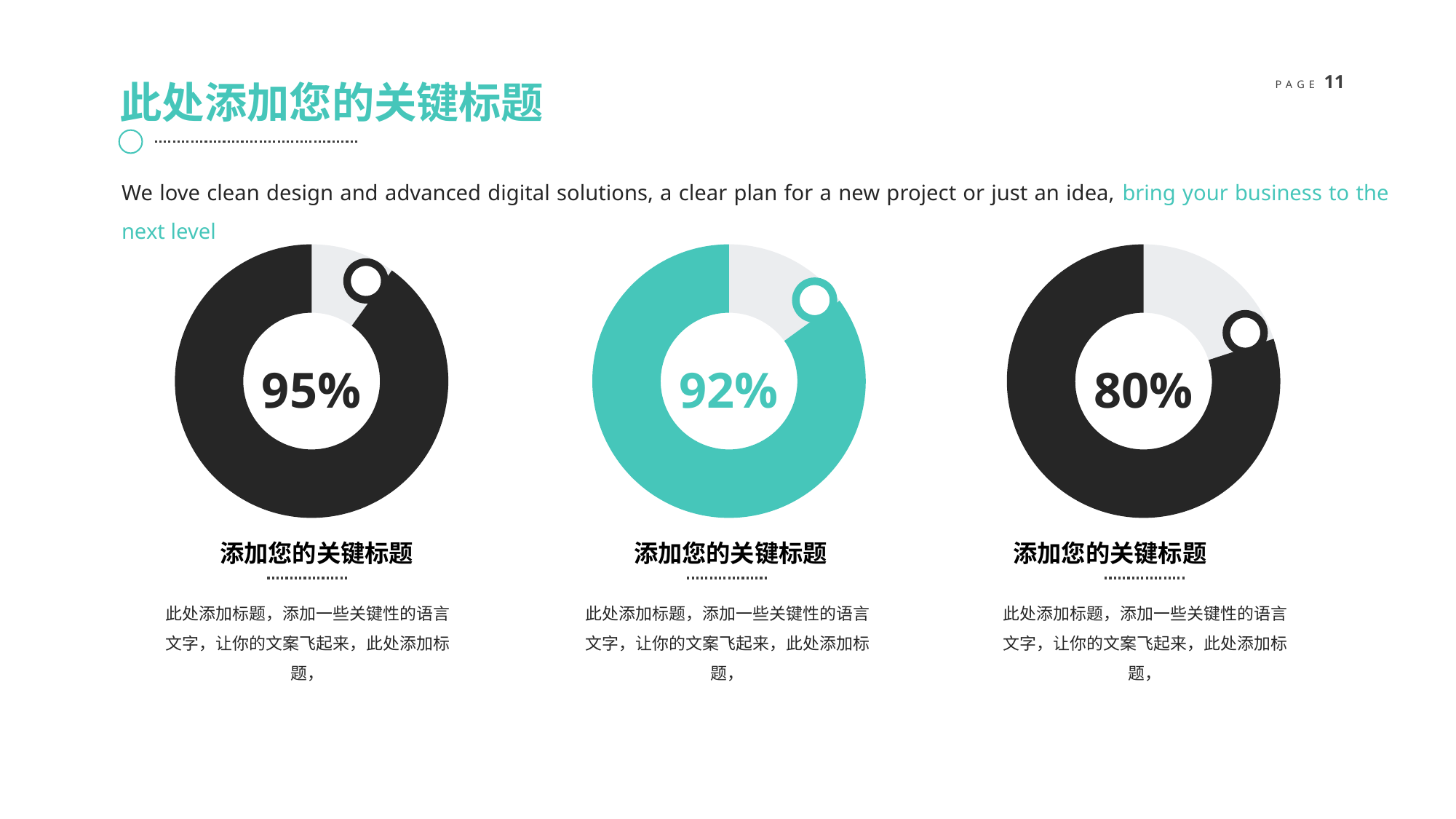
What is the difference between the percentage in the left donut chart and the percentage in the right donut chart? 15% Which donut chart uses a teal (green-blue) fill colour instead of black? The middle chart (92%) Which of the three donut charts shows the lowest percentage? The right chart (80%) Is the percentage shown in the right donut chart greater or less than 90%? less How many donut charts are on the slide? 3 What value is shown in the centre of the middle donut chart? 92% What kind of chart is used to display the three percentages on the slide? Donut chart What value is shown in the centre of the left donut chart? 95% What is the difference between the percentage in the left donut chart and the percentage in the middle donut chart? 3% Which is larger, the percentage in the middle donut chart or the percentage in the right donut chart? The middle chart (92%) Which of the three donut charts shows the highest percentage? The left chart (95%) What value is shown in the centre of the right donut chart? 80%